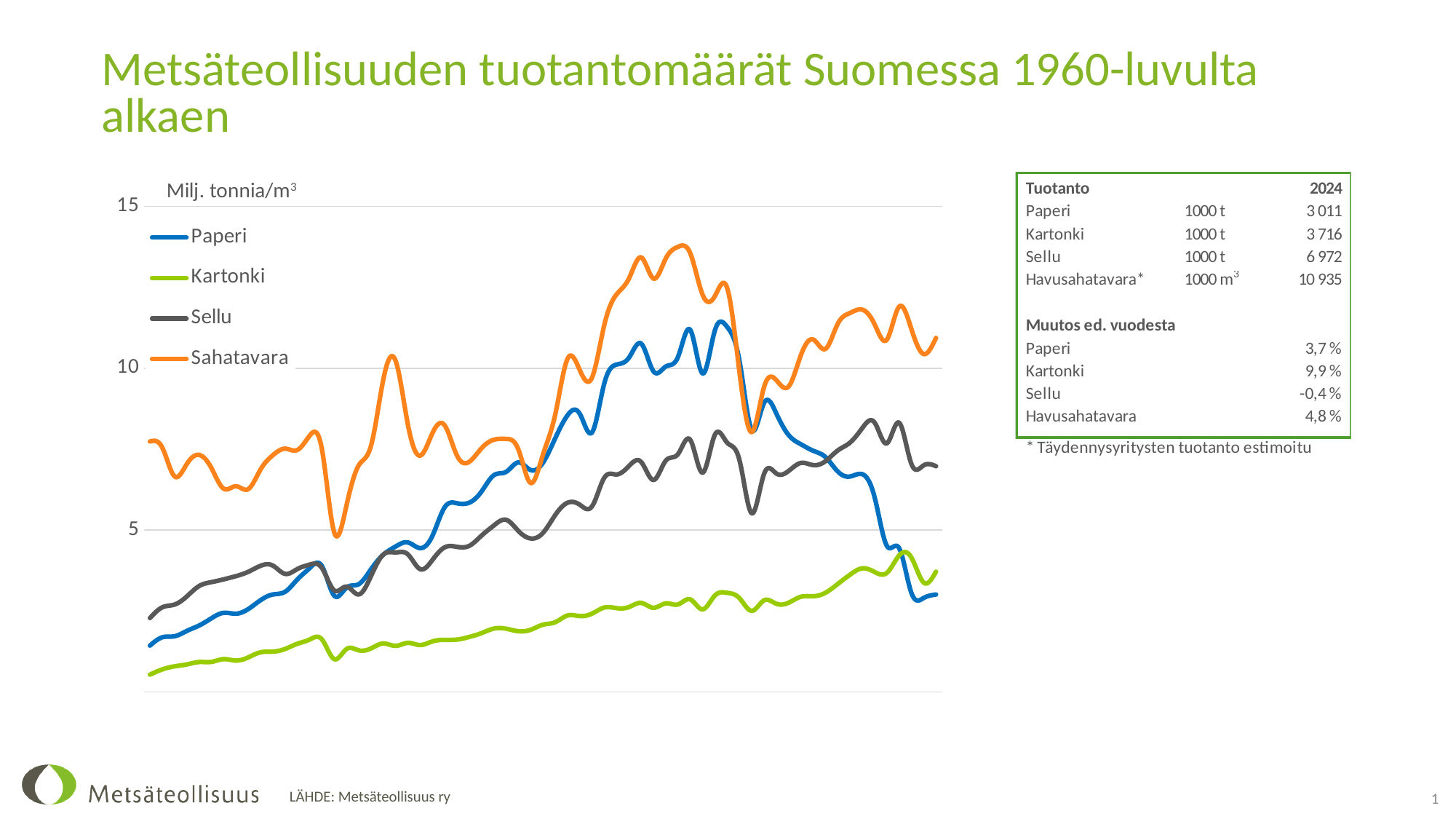
At the right end of the chart, which series is higher, Sahatavara or Sellu? Sahatavara Is the value of the Paperi line at the right end of the chart greater or less than 5? less What unit is shown at the top of the chart's vertical axis? Milj. tonnia/m³ Is the highest value of the Kartonki line greater or less than 5? less Is the highest value of the Sellu line greater or less than 10? less How many series does the chart's legend list? 4 Which series reaches the highest value anywhere on the chart? Sahatavara Which series are listed in the chart's legend? Paperi, Kartonki, Sellu, Sahatavara What kind of chart is shown on the slide? line chart Does the Kartonki line generally rise or fall from left to right across the chart? rise Which series stays lowest for almost the entire chart? Kartonki